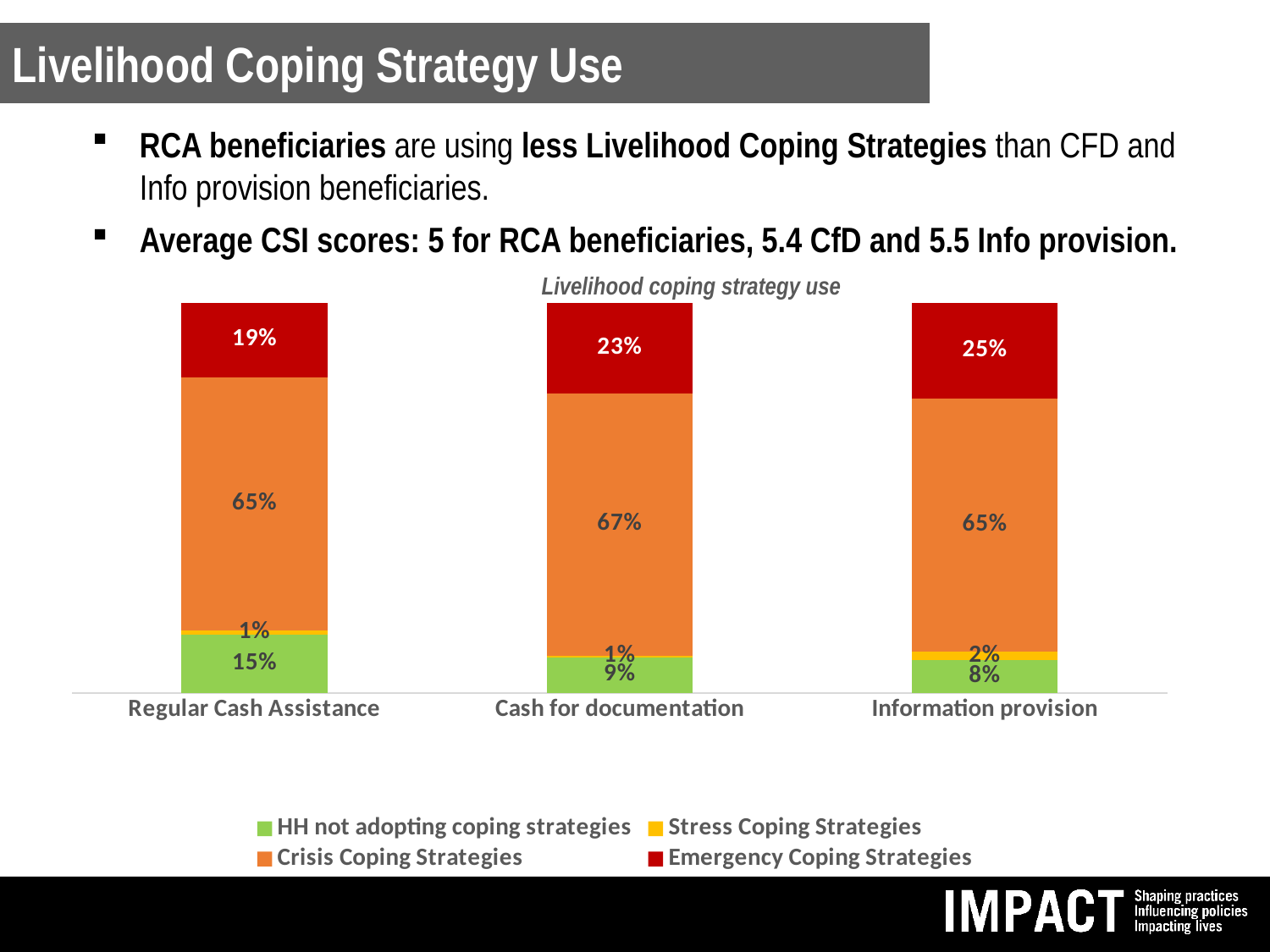
Which category has the highest value for Emergency Coping Strategies? Information provision What is the value for Stress Coping Strategies for Information provision? 2% What type of chart is shown on the slide? Stacked bar chart What is the value for HH not adopting coping strategies for Information provision? 8% How many series does the legend list? 4 How many categories are shown on the x axis? 3 What is the difference between the Emergency Coping Strategies values for Information provision and Regular Cash Assistance? 6% What is the value for Crisis Coping Strategies for Cash for documentation? 67% What is the value for Emergency Coping Strategies for Regular Cash Assistance? 19% What is the title of the chart? Livelihood coping strategy use Which category has the lowest value for HH not adopting coping strategies? Information provision Which is larger: the HH not adopting coping strategies value for Regular Cash Assistance or for Cash for documentation? Regular Cash Assistance